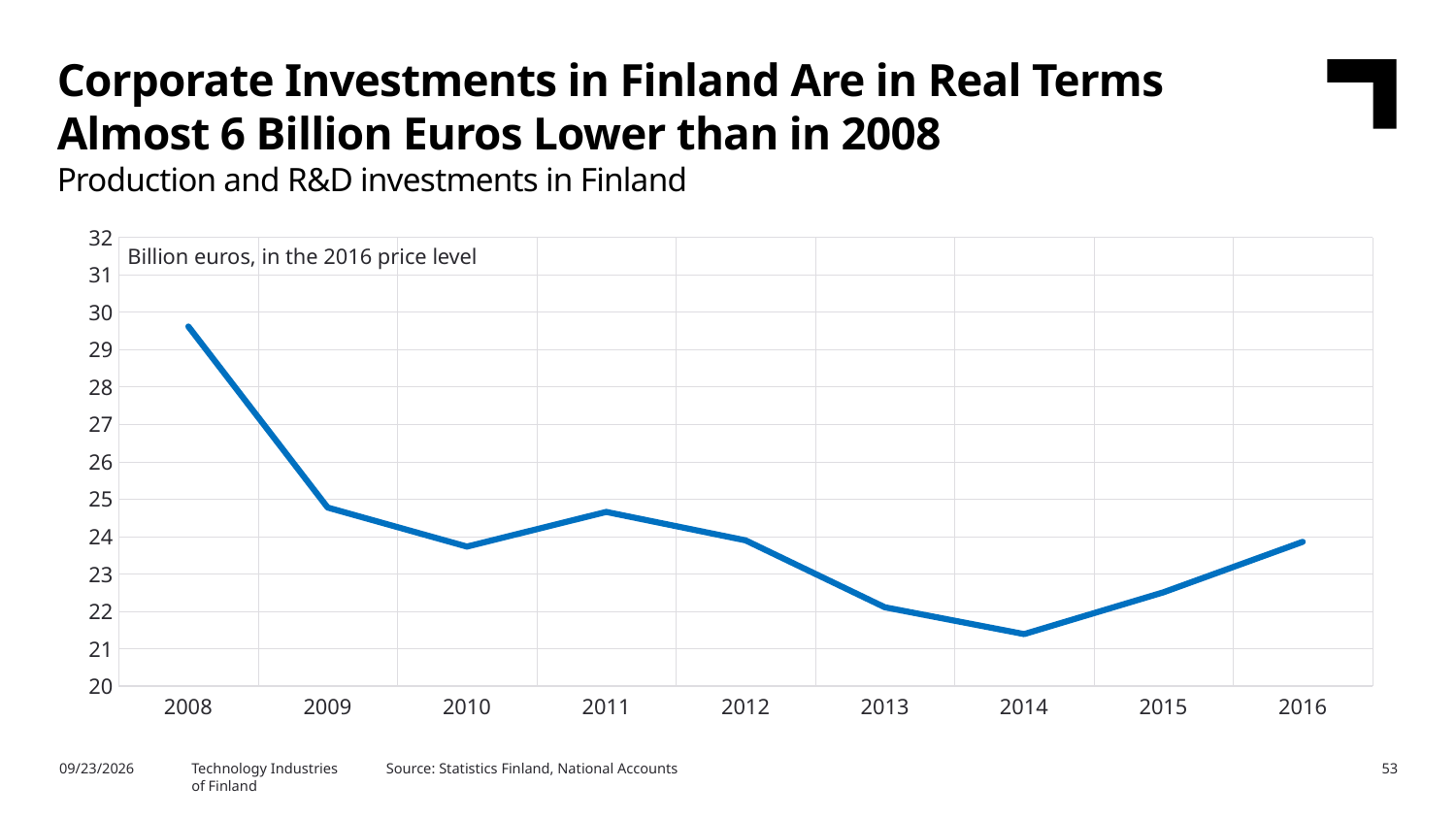
Is the value for 2014 greater or less than 22? less Do the values rise or fall from 2008 to 2010? fall Which year has the lowest value of production and R&D investments in Finland? 2014 How many years are plotted on the x axis of the chart? 9 Is the value for 2013 greater or less than 23? less Which year has the highest value of production and R&D investments in Finland? 2008 Is the value for 2008 greater or less than 29? greater What kind of chart is shown on the slide? line chart Which year has the larger value, 2015 or 2016? 2016 What unit is stated in the label inside the chart area? Billion euros, in the 2016 price level Which year has the larger value, 2008 or 2016? 2008